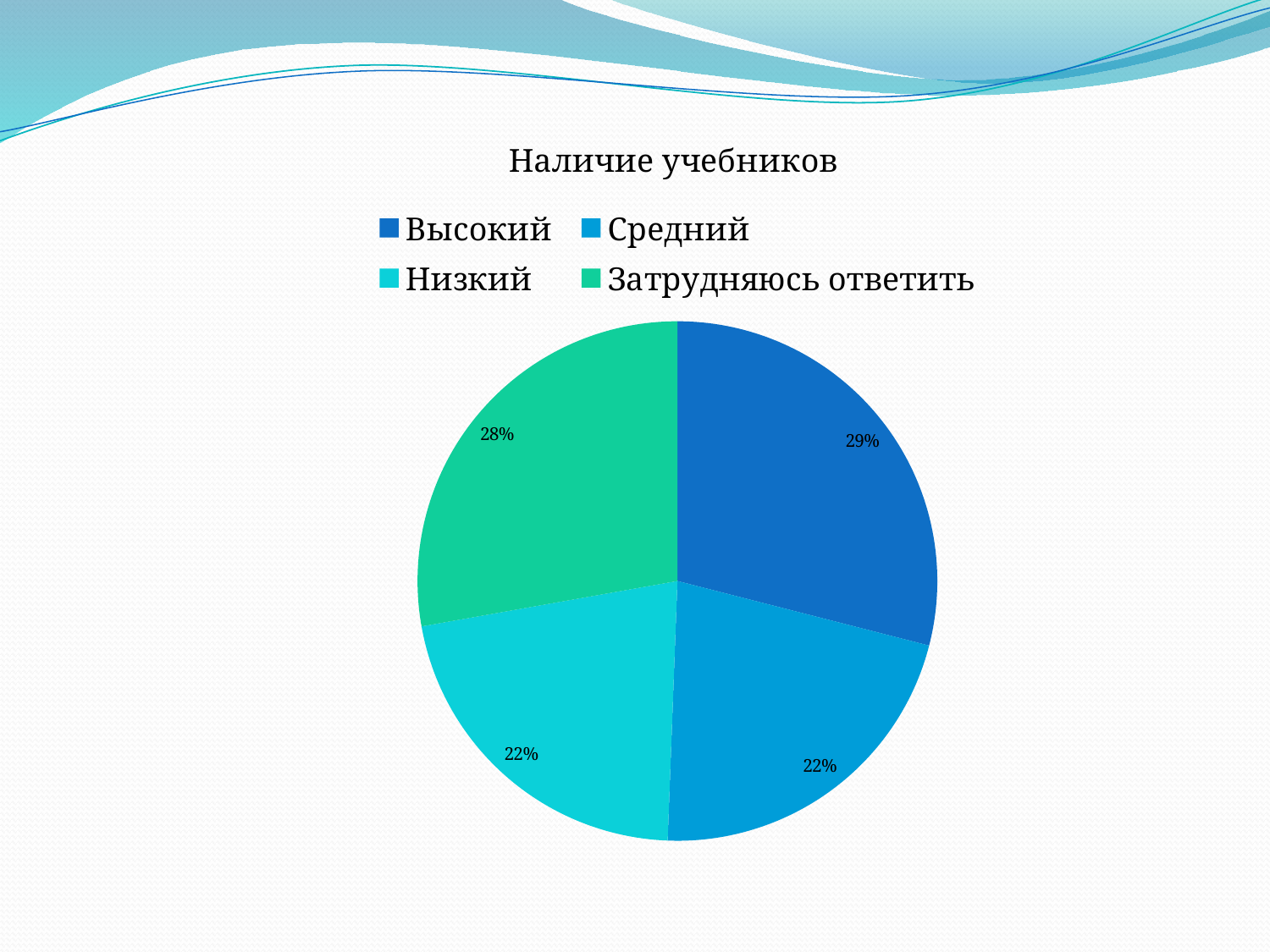
What is the title of the chart? Наличие учебников What share of the pie is labelled for Средний? 22% What share of the pie is labelled for Высокий? 29% How many entries does the legend list? 4 Which is larger, the share for Затрудняюсь ответить or the share for Низкий? Затрудняюсь ответить Which category has the largest slice of the pie? Высокий What is the difference between the shares for Высокий and Средний? 7% What kind of chart is shown on the slide? pie chart What is the difference between the shares for Затрудняюсь ответить and Низкий? 6% How many slices does the pie chart have? 4 What share of the pie is labelled for Затрудняюсь ответить? 28%